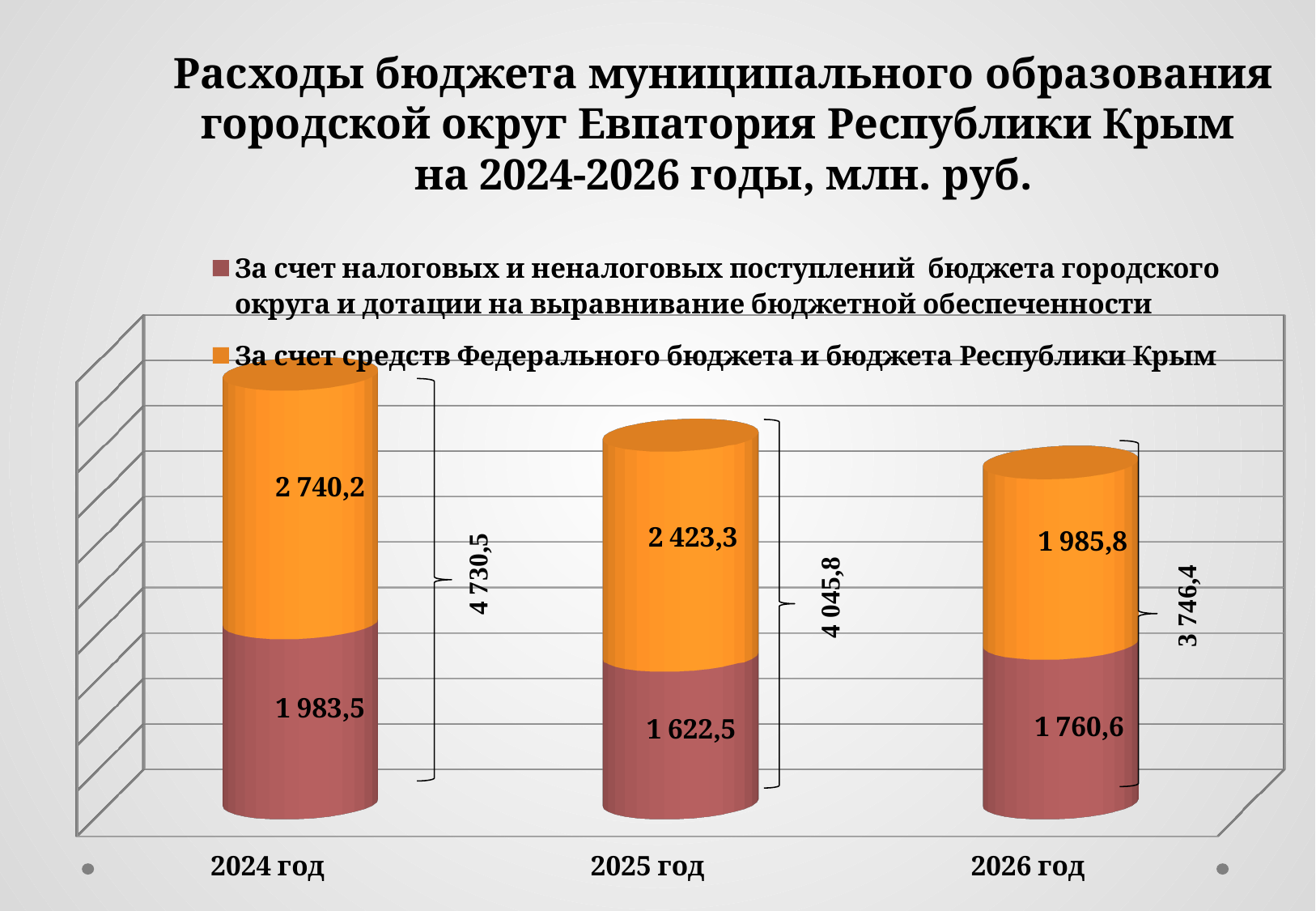
Do the total expenditures rise or fall from 2024 год to 2026 год? Fall Which year has the highest total expenditure? 2024 год What is the value for 'За счет налоговых и неналоговых поступлений бюджета городского округа и дотации на выравнивание бюджетной обеспеченности' in 2025 год? 1 622,5 What is the difference between the 'За счет средств Федерального бюджета и бюджета Республики Крым' values for 2024 год and 2026 год? 754,4 How many years (categories) are shown on the x axis? 3 What is the total shown for the 2025 год bar? 4 045,8 What is the value for 'За счет средств Федерального бюджета и бюджета Республики Крым' in 2024 год? 2 740,2 What type of chart is shown on the slide? Stacked bar chart Which year has the lowest value for 'За счет налоговых и неналоговых поступлений бюджета городского округа и дотации на выравнивание бюджетной обеспеченности'? 2025 год What is the total shown for the 2026 год bar? 3 746,4 What is the value for 'За счет средств Федерального бюджета и бюджета Республики Крым' in 2026 год? 1 985,8 How many series does the legend list? 2